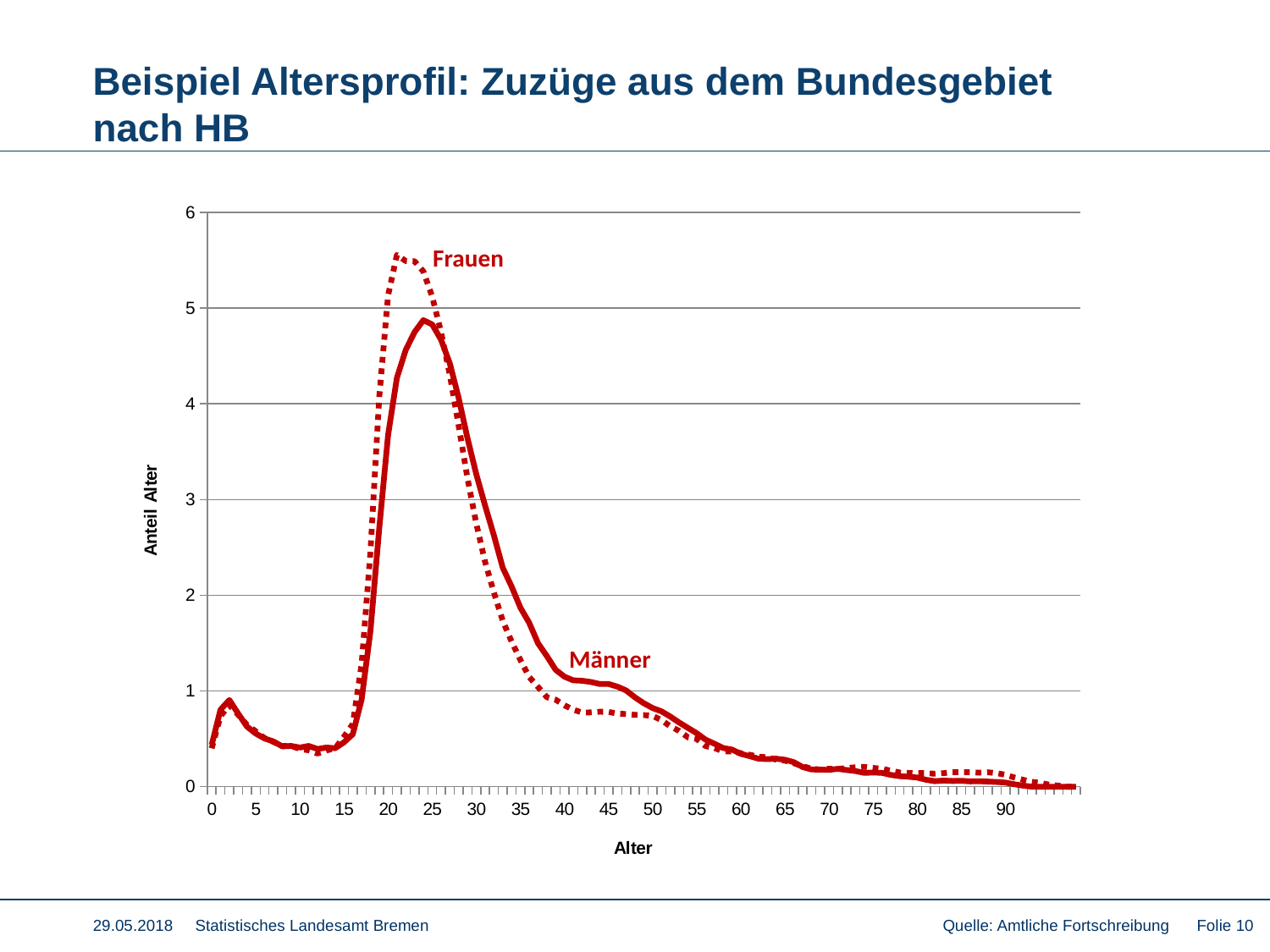
What is the label of the y axis? Anteil Alter At age 30, which series has the higher value, Frauen or Männer? Männer What is the label of the x axis? Alter What kind of chart is shown on the slide? line chart Between ages 25 and 60, do the values for Männer rise or fall? fall Is the value for Männer at age 35 greater or less than 1? greater At age 20, which series has the higher value, Frauen or Männer? Frauen Is the peak value of the Frauen series greater or less than 5? greater Which series reaches the higher peak, Frauen or Männer? Frauen Is the value for Frauen at age 40 greater or less than 1? less How many series are plotted in the chart? 2